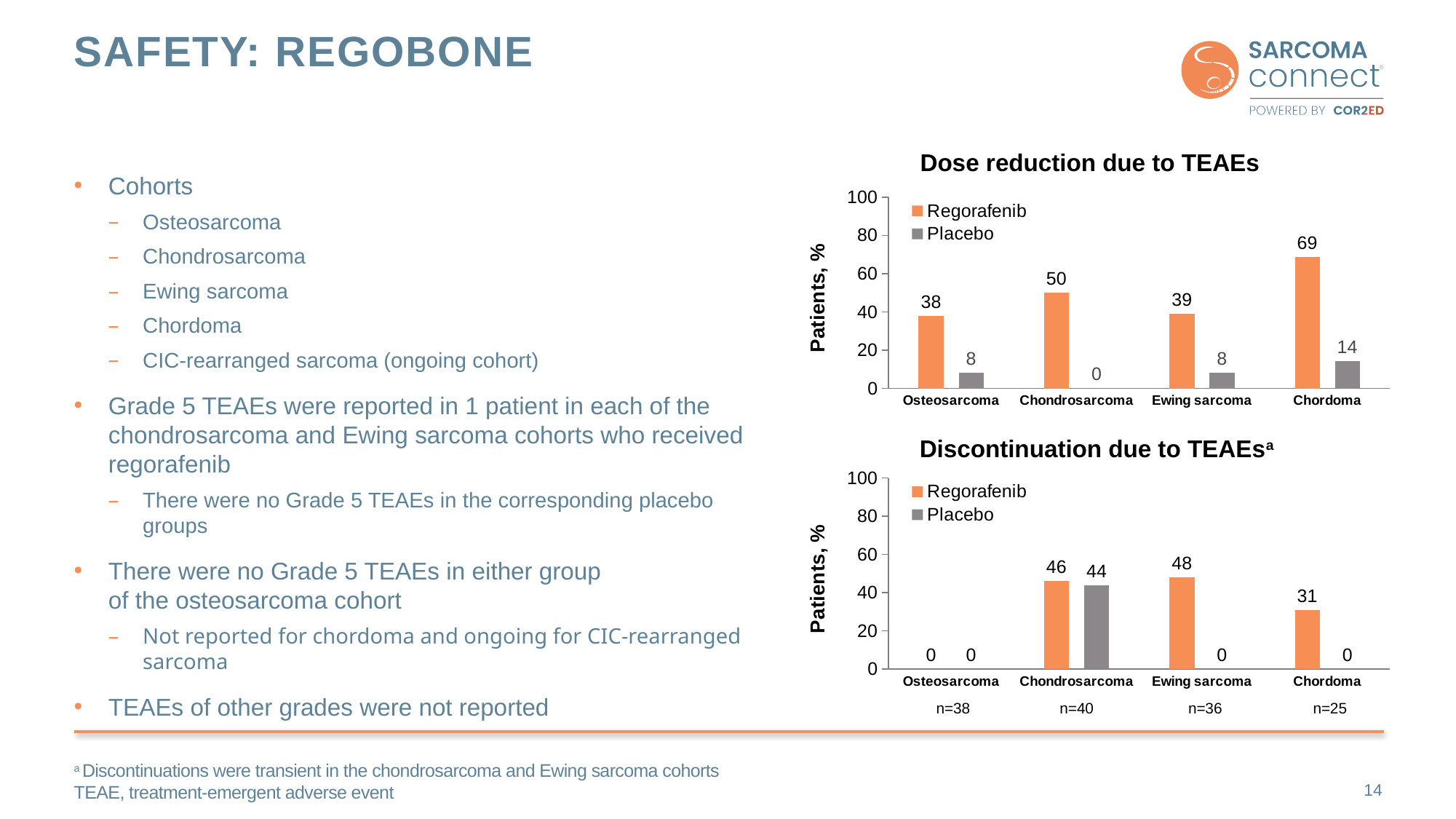
How many series does the legend of the 'Discontinuation due to TEAEs' chart list? 2 In the 'Discontinuation due to TEAEs' chart, what is the difference between the Regorafenib and Placebo values for Ewing sarcoma? 48 What type of chart is the 'Dose reduction due to TEAEs' chart? Bar chart In the 'Discontinuation due to TEAEs' chart, what is the value for Regorafenib in the Chordoma cohort? 31 In the 'Dose reduction due to TEAEs' chart, what is the value for Regorafenib in the Chordoma cohort? 69 In the 'Dose reduction due to TEAEs' chart, what is the difference between the Regorafenib and Placebo values for Osteosarcoma? 30 In the 'Dose reduction due to TEAEs' chart, which cohort has the highest Regorafenib value? Chordoma How many cohorts are shown on the x axis of the 'Dose reduction due to TEAEs' chart? 4 In the 'Dose reduction due to TEAEs' chart, which is larger: the Regorafenib value for Chondrosarcoma or for Ewing sarcoma? Chondrosarcoma In the 'Discontinuation due to TEAEs' chart, which cohort has the highest Regorafenib value? Ewing sarcoma In the 'Dose reduction due to TEAEs' chart, what is the value for Placebo in the Chondrosarcoma cohort? 0 In the 'Discontinuation due to TEAEs' chart, what is the value for Placebo in the Chondrosarcoma cohort? 44